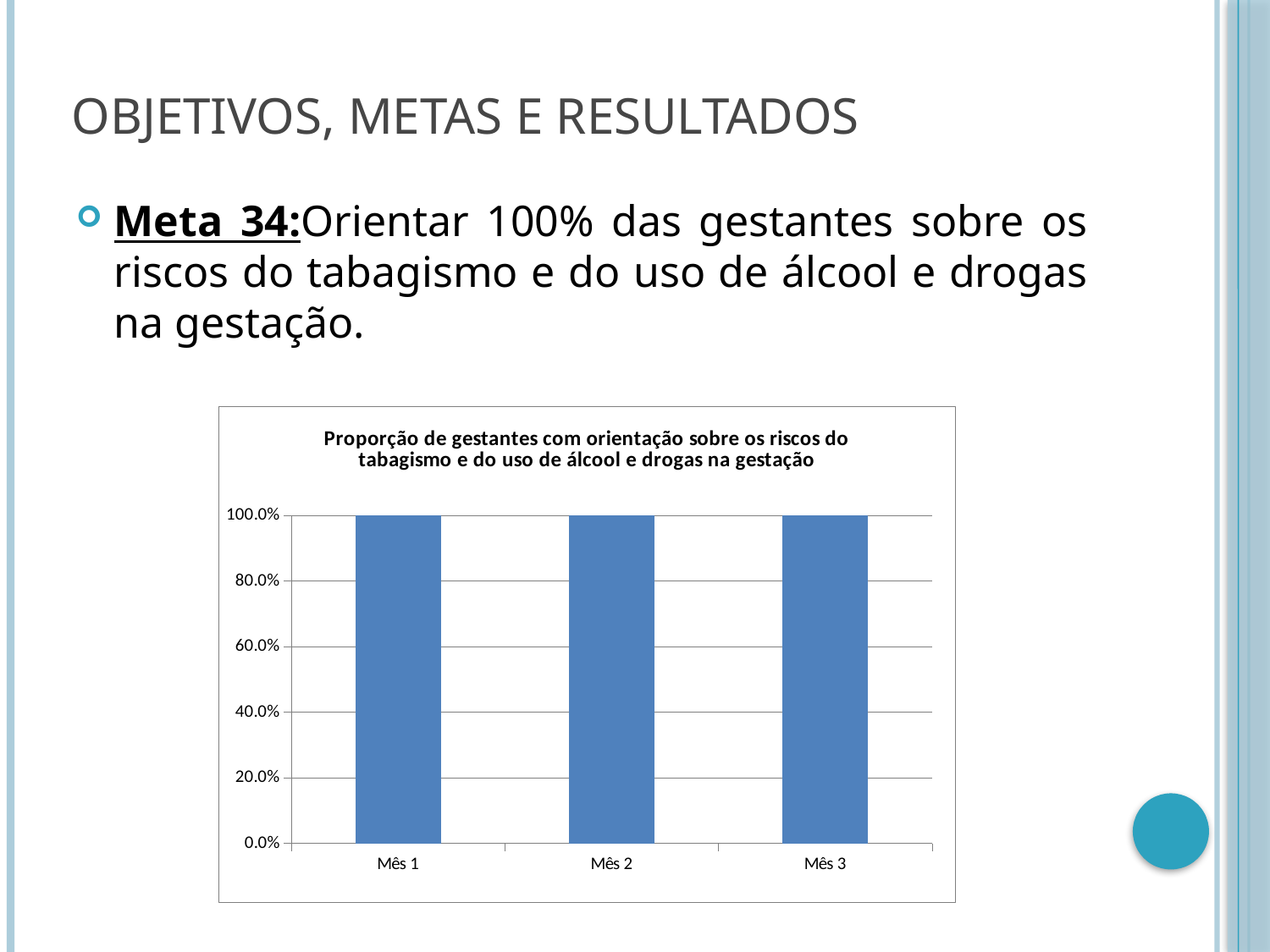
What is the value for Mês 1? 100.0% What is the title of the chart? Proporção de gestantes com orientação sobre os riscos do tabagismo e do uso de álcool e drogas na gestação What is the difference between the values for Mês 1 and Mês 3? 0.0% Do the values rise, fall or stay the same from Mês 1 to Mês 3? stay the same Is the value for Mês 3 greater or less than 60.0%? greater What is the value for Mês 3? 100.0% How many categories (months) are plotted on the chart? 3 What type of chart is shown on the slide? bar chart Is the value for Mês 2 greater or less than 80.0%? greater What is the highest value shown on the vertical axis? 100.0% What colour are the bars in the chart? blue What is the value for Mês 2? 100.0%